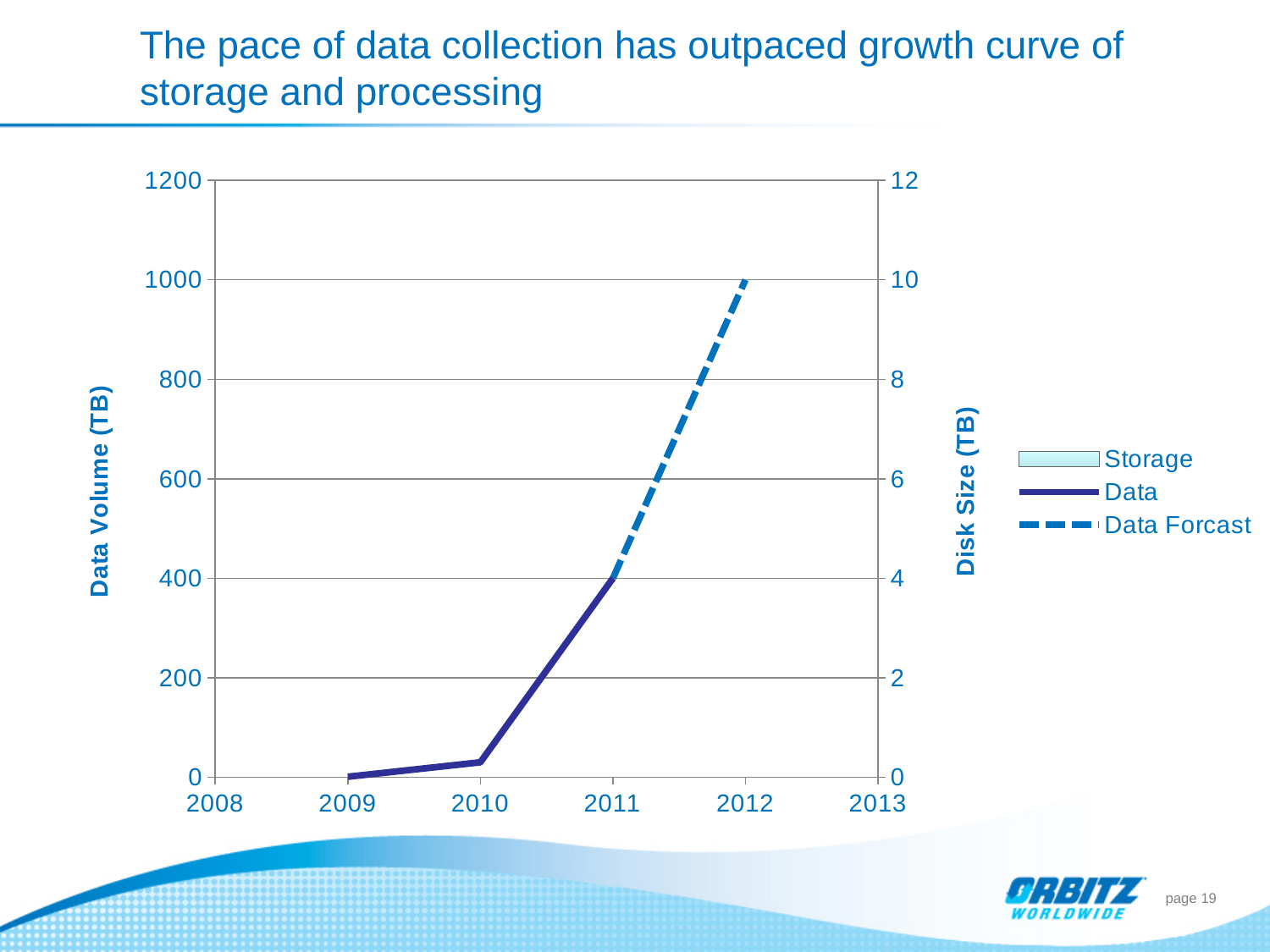
In which year does the Data Forcast series reach its highest value? 2012 What is the Data Forcast value for 2012 on the left axis? 1000 How many year labels are shown on the x axis? 6 Is the Data Forcast value for 2012 greater or less than 800? greater What kind of chart is shown on the slide? line chart How many series does the legend list? 3 Which is larger, the Data value for 2010 or the Data value for 2011? 2011 What is the title of the left vertical axis? Data Volume (TB) Is the Data value for 2010 greater or less than 200? less Is the Data value for 2011 greater or less than 200? greater What are the three entries in the chart legend? Storage, Data, Data Forcast Does the Data series rise or fall from 2009 to 2011? rise